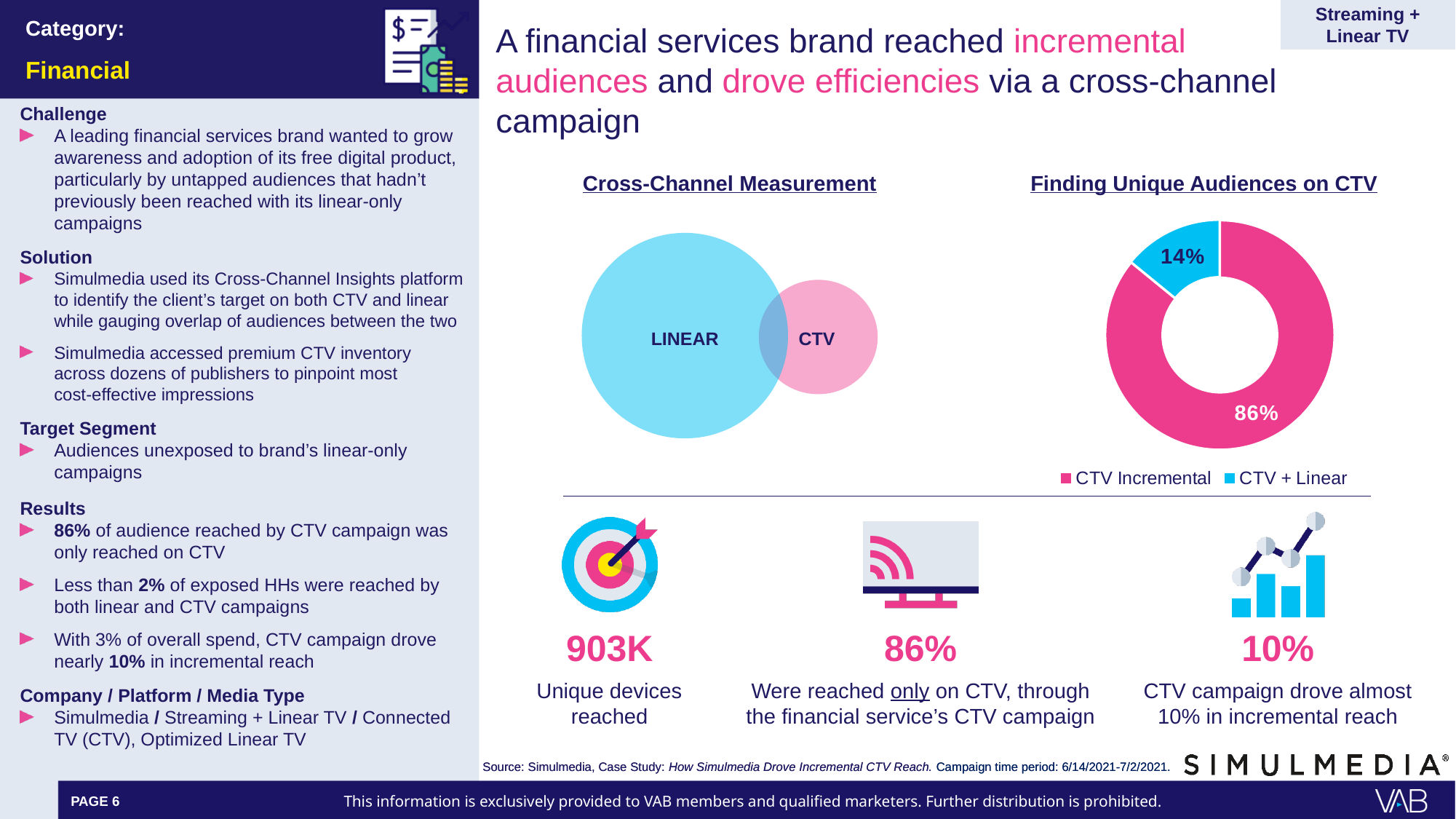
In the "Finding Unique Audiences on CTV" chart, what is the total of the two slices? 100% How many slices does the "Finding Unique Audiences on CTV" chart have? 2 In the "Finding Unique Audiences on CTV" chart, what is the difference in percentage points between the CTV Incremental and CTV + Linear slices? 72 In the "Finding Unique Audiences on CTV" chart, what colour is the CTV + Linear slice? Blue In the "Finding Unique Audiences on CTV" chart, what share is labelled for CTV Incremental? 86% In the "Finding Unique Audiences on CTV" chart, what share is labelled for CTV + Linear? 14% In the "Finding Unique Audiences on CTV" chart, which slice is the smallest? CTV + Linear In the "Finding Unique Audiences on CTV" chart, which is larger: CTV Incremental or CTV + Linear? CTV Incremental What kind of chart is "Finding Unique Audiences on CTV"? Donut (pie) chart In the "Finding Unique Audiences on CTV" chart, which slice is the largest? CTV Incremental In the "Finding Unique Audiences on CTV" chart, what colour is the CTV Incremental slice? Pink How many entries does the legend of the "Finding Unique Audiences on CTV" chart list? 2